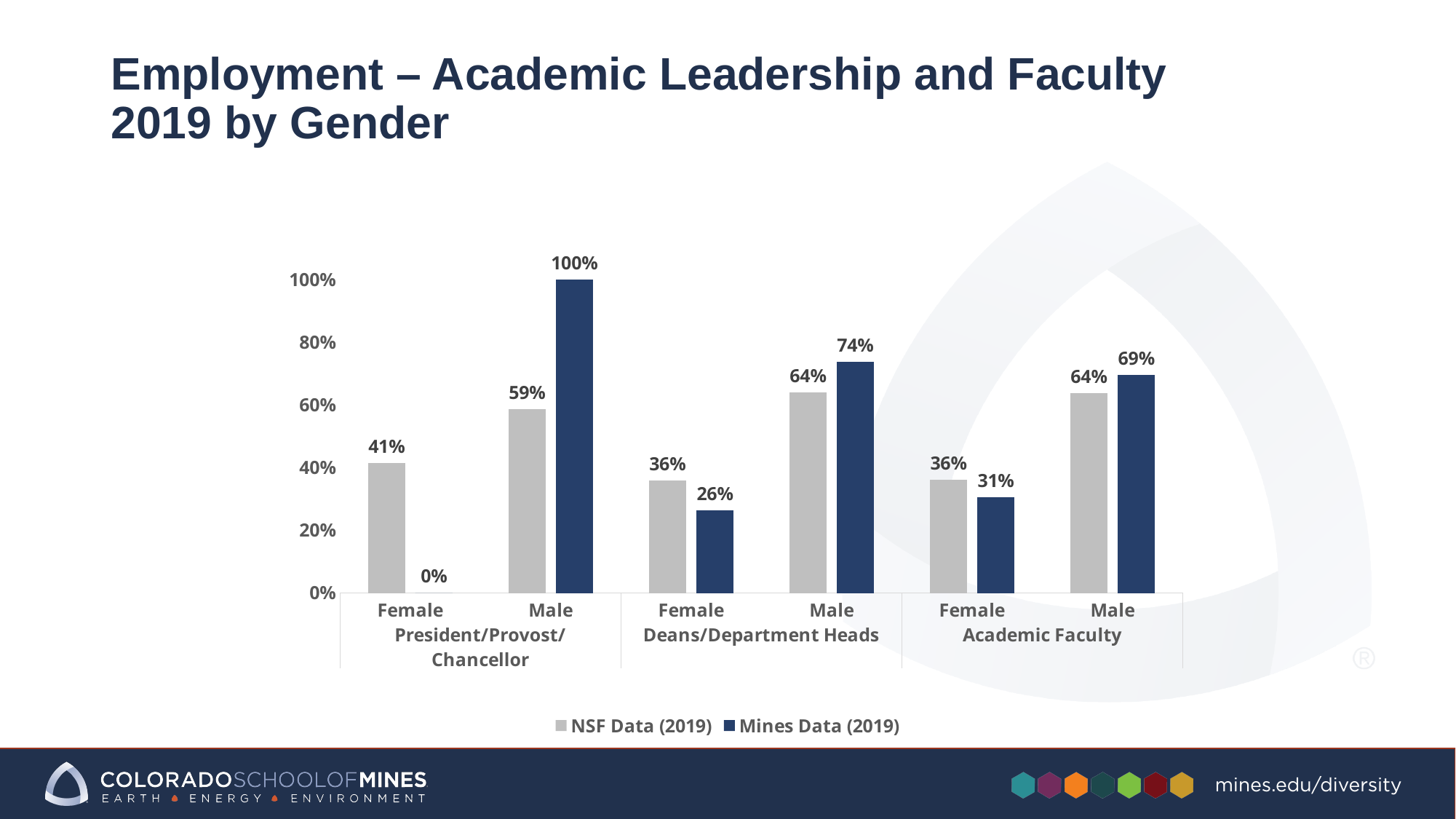
Which category has the lowest Mines Data (2019) value? Female President/Provost/Chancellor Which is larger for Female Academic Faculty: the NSF Data (2019) value or the Mines Data (2019) value? NSF Data (2019) Which colour represents Mines Data (2019) in the chart? Dark blue What is the Mines Data (2019) value for Female President/Provost/Chancellor? 0% What kind of chart is shown on the slide? Bar chart How many categories are shown on the x axis? 6 What is the NSF Data (2019) value for Female Deans/Department Heads? 36% What is the Mines Data (2019) value for Male President/Provost/Chancellor? 100% Which category has the highest Mines Data (2019) value? Male President/Provost/Chancellor What is the Mines Data (2019) value for Female Academic Faculty? 31% What is the difference between the Mines Data (2019) and NSF Data (2019) values for Male Deans/Department Heads? 10% How many series does the legend list? 2